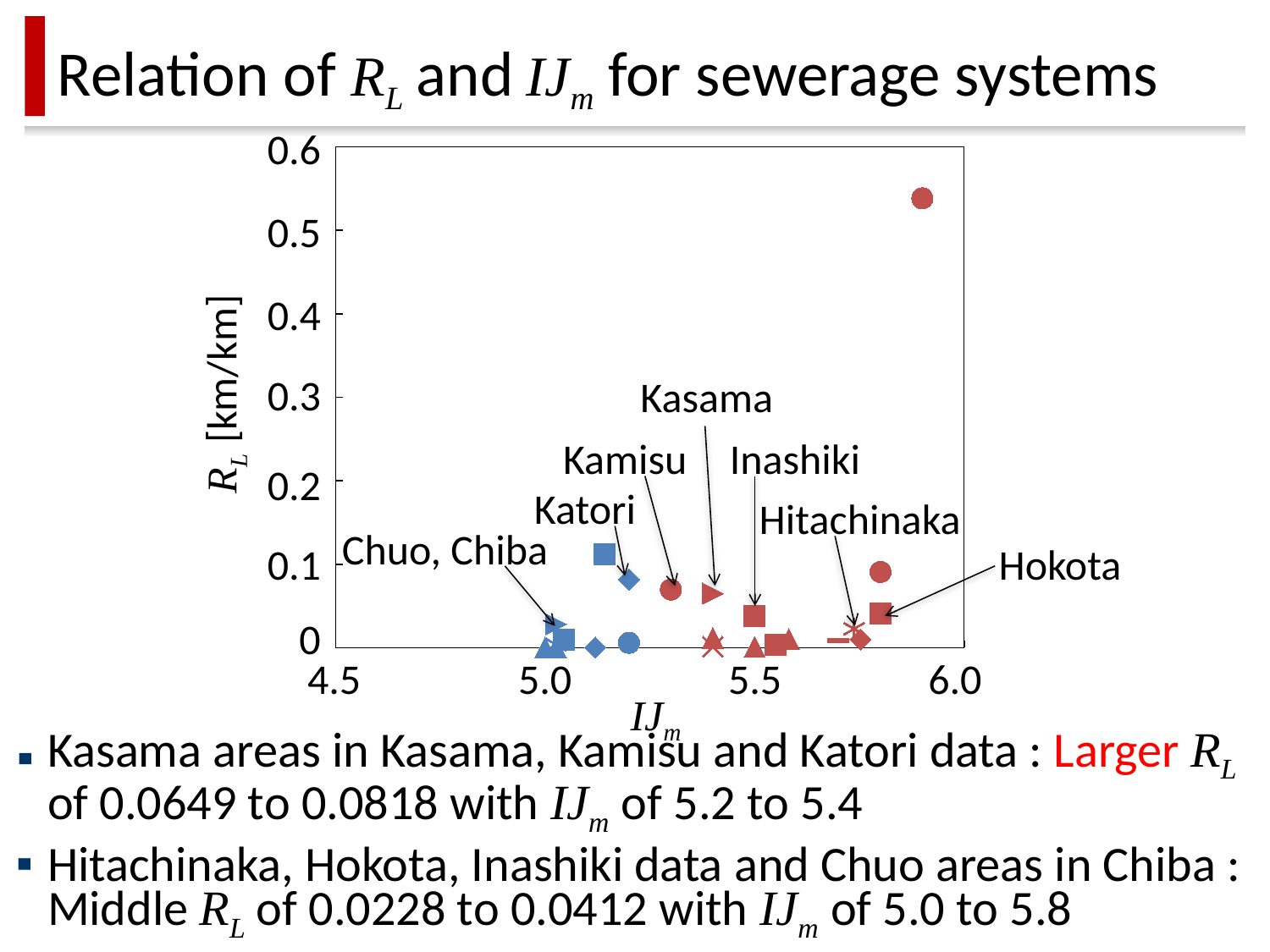
Which has the larger RL value, the Katori point or the Kasama point? Katori Is the RL value of the highest point on the chart greater or less than 0.5? greater Is the IJm value for the Hokota point greater or less than 5.5? greater What is the title of the chart on the slide? Relation of RL and IJm for sewerage systems Which has the larger RL value, the Kamisu point or the Hokota point? Kamisu What is the label of the y axis of the chart? RL [km/km] Is the RL value for the Hokota point greater or less than 0.1? less How many points on the chart are labeled with a place name? 7 What kind of chart is shown on the slide? scatter chart